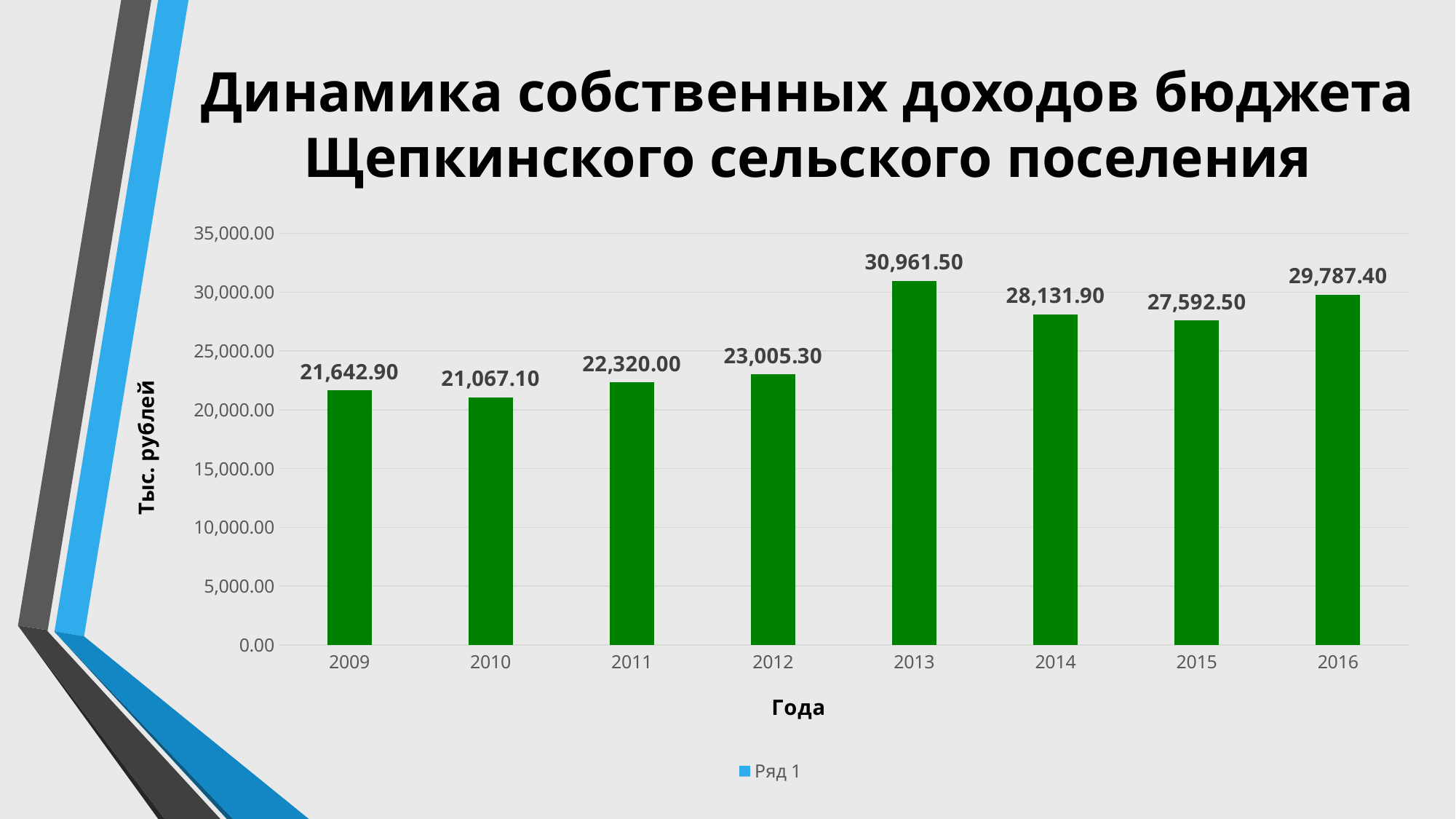
What is the value for 2013? 30,961.50 Is the value for 2012 greater or less than 25,000.00? less Which year has the highest value? 2013 How many years are shown on the x axis? 8 What is the value for 2010? 21,067.10 What is the label of the vertical axis? Тыс. рублей What kind of chart is shown on the slide? bar chart What is the difference between the values for 2016 and 2015? 2,194.90 What is the difference between the values for 2013 and 2009? 9,318.60 What is the value for 2016? 29,787.40 Which is larger, the value for 2014 or the value for 2015? 2014 Which year has the lowest value? 2010